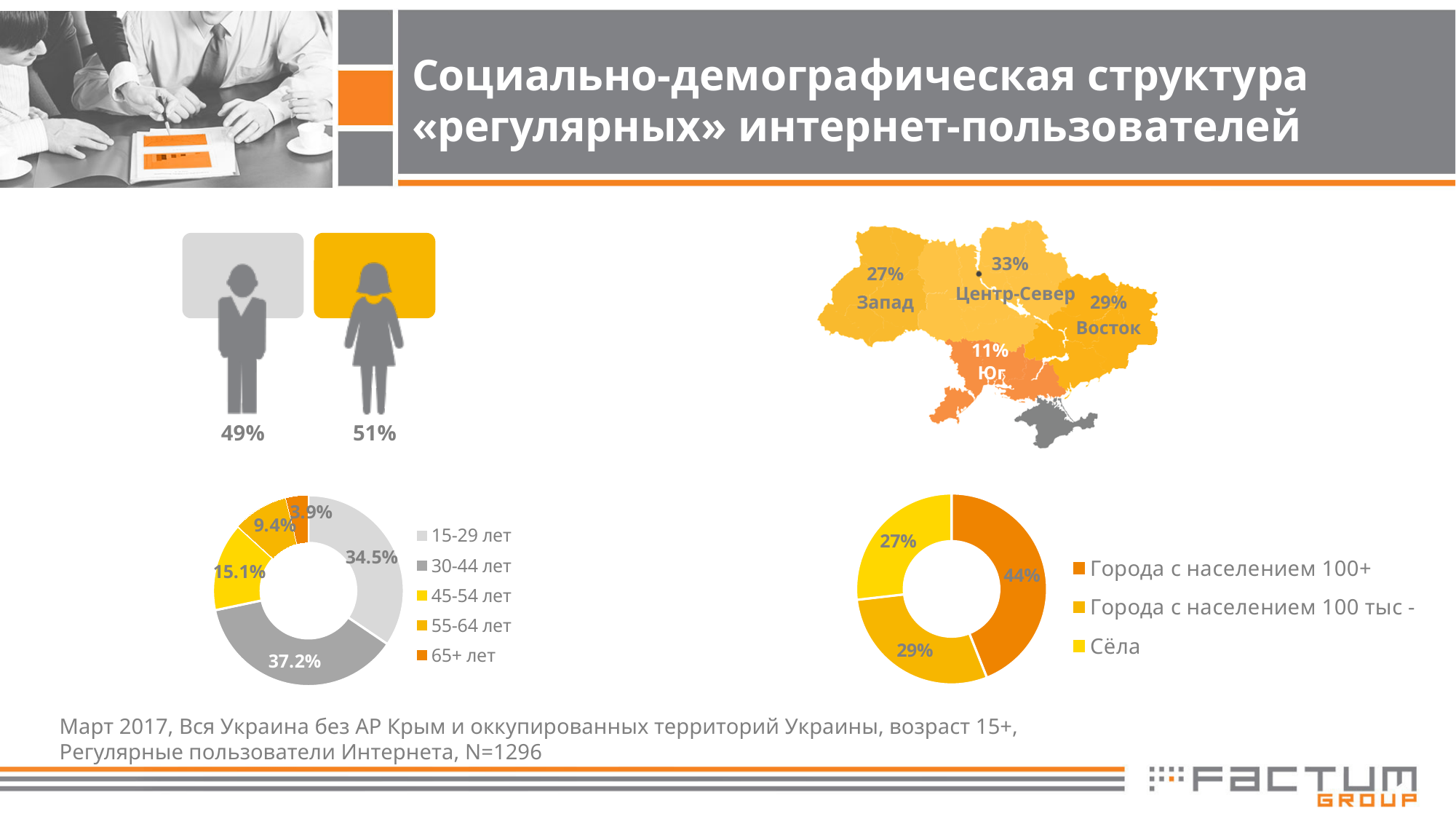
In the bottom-left age donut chart, what is the difference between the shares of the 30-44 лет and 15-29 лет groups? 2.7% In the bottom-right donut chart, what is the difference between the shares of Города с населением 100+ and Города с населением 100 тыс -? 15% How many age groups are shown in the bottom-left donut chart? 5 In the bottom-left age donut chart, which age group has the smallest share? 65+ лет In the bottom-left age donut chart, what share is shown for the 30-44 лет group? 37.2% In the bottom-left age donut chart, which is larger: the share for 55-64 лет or for 65+ лет? 55-64 лет In the bottom-left age donut chart, which age group has the largest share? 30-44 лет How many categories does the legend of the bottom-right donut chart list? 3 In the bottom-left age donut chart, what share is shown for the 45-54 лет group? 15.1% In the bottom-right donut chart, what share is shown for Сёла? 27% What type of chart is used in the bottom-right to show settlement types? Donut (pie) chart In the bottom-right donut chart, which category has the largest share? Города с населением 100+